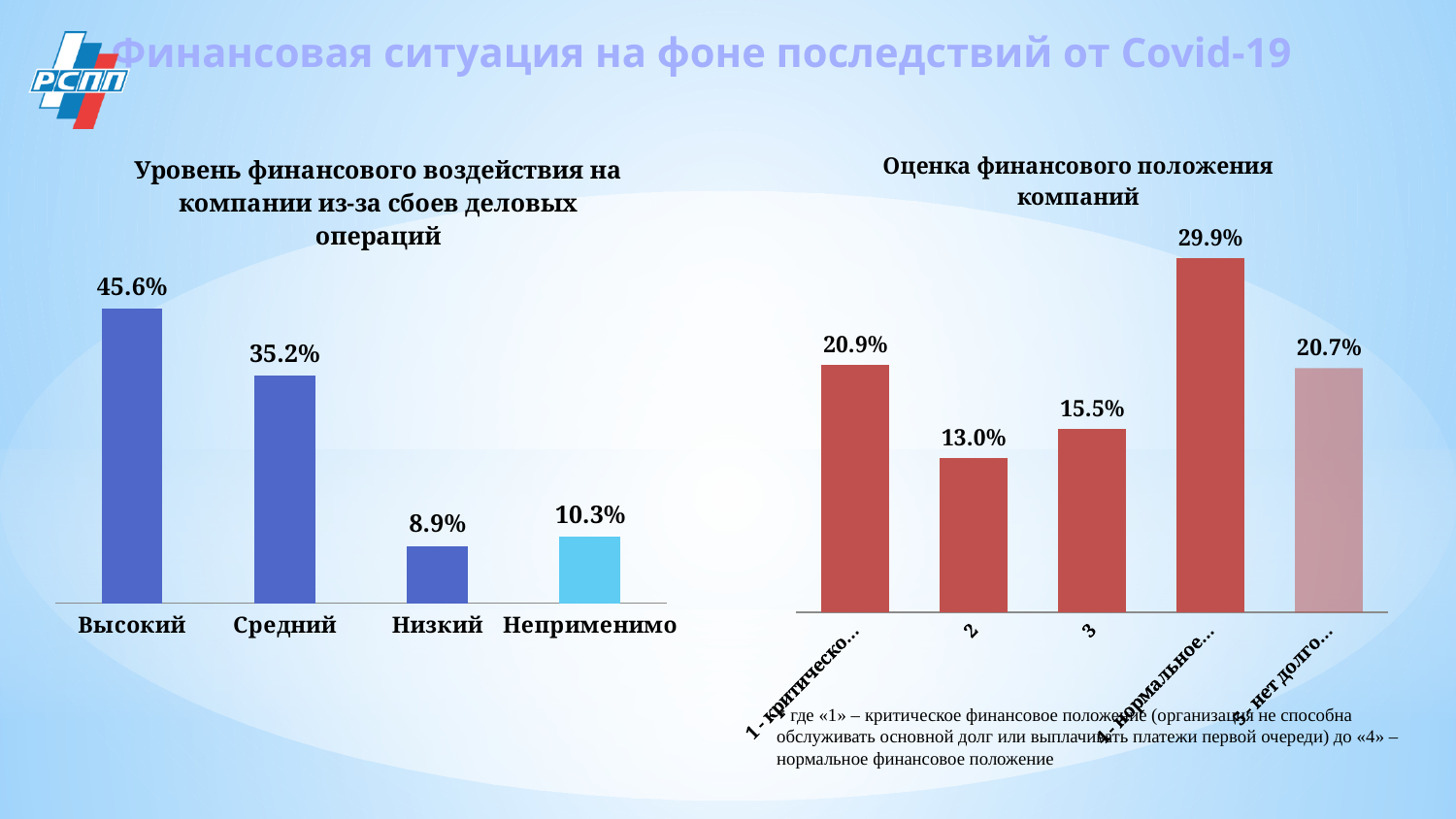
What type of chart is the right chart (Оценка финансового положения компаний)? Bar chart How many categories are shown in the left chart (Уровень финансового воздействия)? 4 In the right chart (Оценка финансового положения компаний), what is the value for category 2? 13.0% In the right chart (Оценка финансового положения компаний), what is the difference between category 3 and category 2? 2.5% In the right chart (Оценка финансового положения компаний), what is the value for category 3? 15.5% In the left chart (Уровень финансового воздействия на компании из-за сбоев деловых операций), what is the value for Высокий? 45.6% In the left chart (Уровень финансового воздействия), which category has the lowest value? Низкий In the left chart (Уровень финансового воздействия), which is larger: Низкий or Неприменимо? Неприменимо In the left chart (Уровень финансового воздействия), what is the value for Средний? 35.2% In the right chart (Оценка финансового положения компаний), what is the highest value shown? 29.9% In the left chart (Уровень финансового воздействия), what is the difference between Высокий and Средний? 10.4% In the left chart (Уровень финансового воздействия), what is the value for Неприменимо? 10.3%